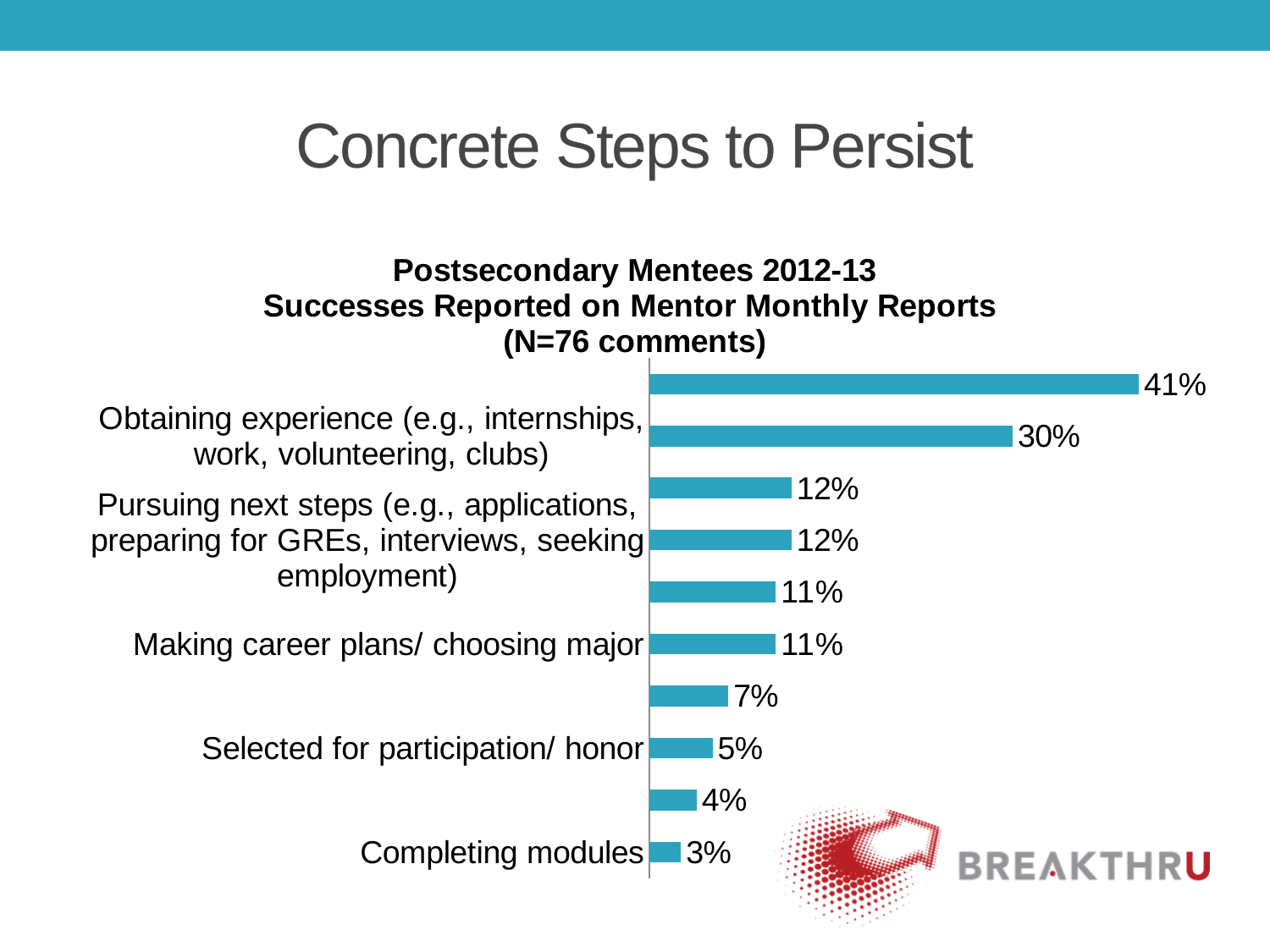
Which is larger, the value for "Selected for participation/ honor" or the value for "Completing modules"? Selected for participation/ honor What is the difference between the values for "Making career plans/ choosing major" and "Completing modules"? 8% What is the value for "Completing modules"? 3% What is the value for "Making career plans/ choosing major"? 11% How many comments does the chart title say the data is based on? N=76 comments What kind of chart is shown on the slide? bar chart What is the value for "Selected for participation/ honor"? 5% What is the value for "Obtaining experience (e.g., internships, work, volunteering, clubs)"? 30% How many bars are plotted on the chart? 10 What is the highest value shown on the chart? 41% Which labeled category has the lowest value? Completing modules What is the value for "Pursuing next steps (e.g., applications, preparing for GREs, interviews, seeking employment)"? 12%